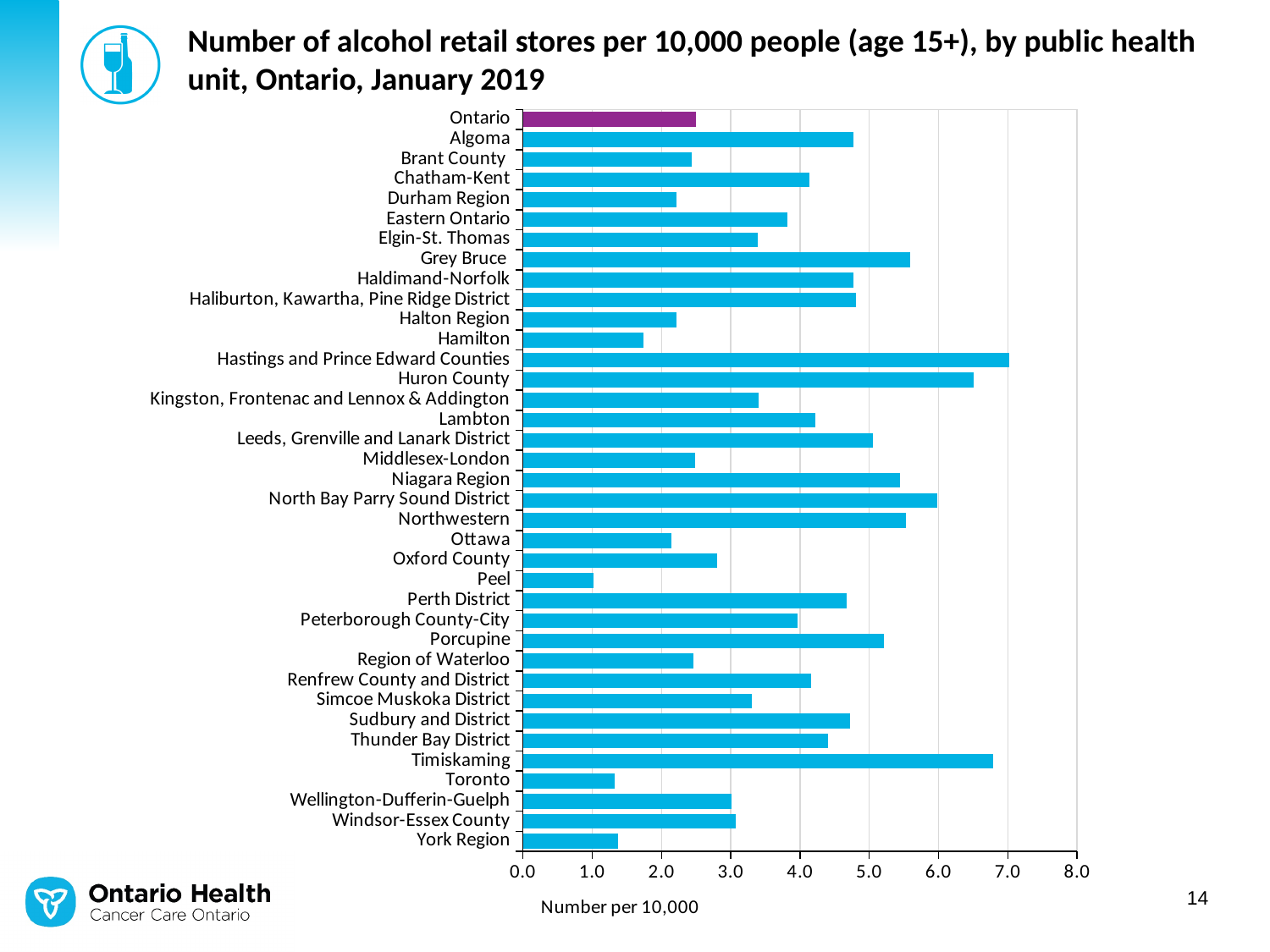
Is the value for Grey Bruce greater or less than 5.0? greater What kind of chart is shown on the slide? bar chart Which public health unit has the highest number of alcohol retail stores per 10,000 people? Hastings and Prince Edward Counties Is the value for Hastings and Prince Edward Counties greater or less than 6.0? greater Which has a higher value, Toronto or Peel? Toronto Is the value for Hamilton greater or less than 2.0? less Which public health unit has the lowest number of alcohol retail stores per 10,000 people? Peel What is the label on the horizontal axis of the chart? Number per 10,000 How many public health units (including Ontario) are plotted on the chart? 37 Which has a higher value, Algoma or Brant County? Algoma